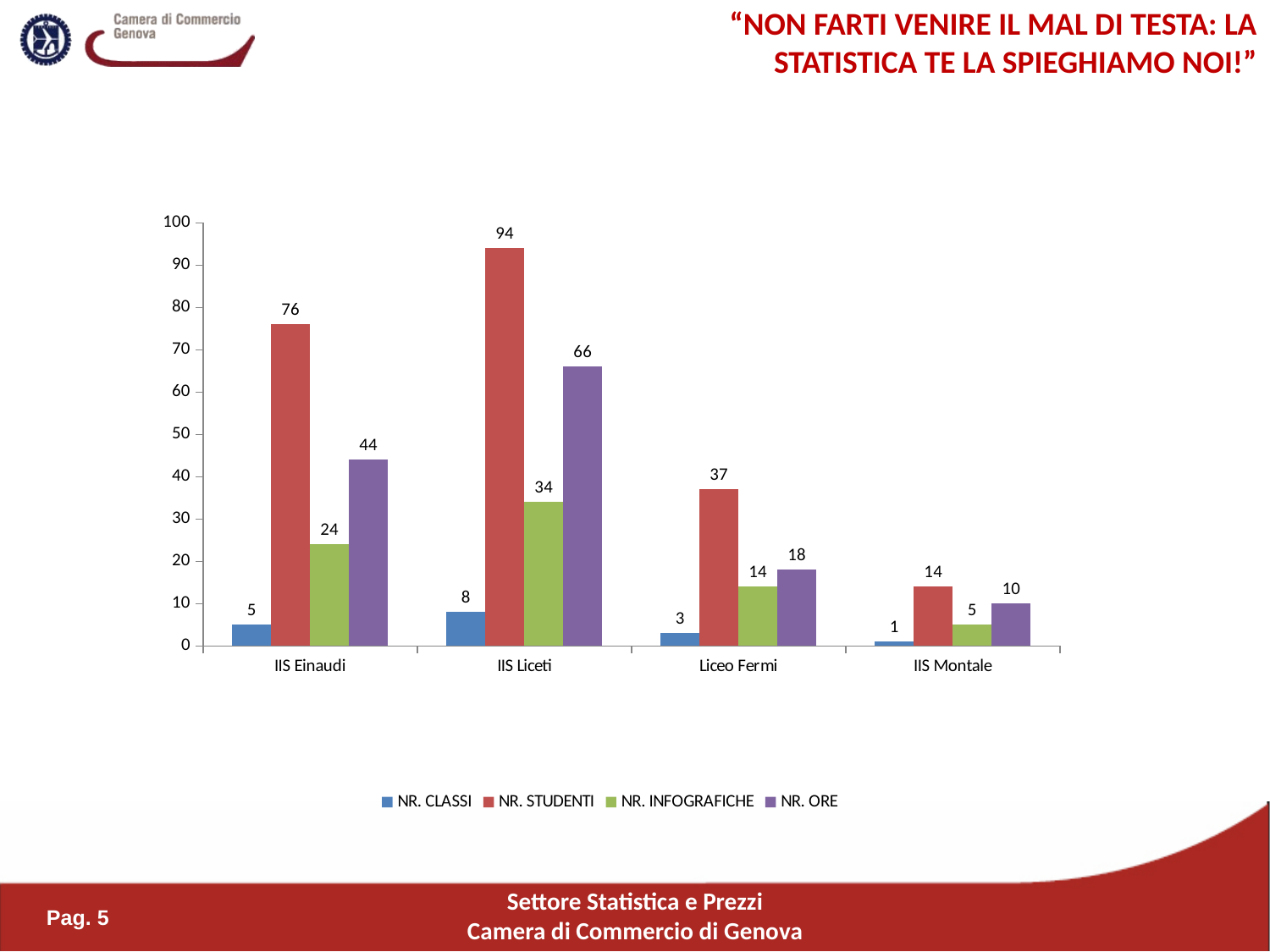
Which is larger: NR. INFOGRAFICHE for IIS Einaudi or NR. ORE for Liceo Fermi? NR. INFOGRAFICHE for IIS Einaudi What is the value of NR. ORE for IIS Einaudi? 44 How many series does the legend list? 4 Which school has the lowest value for NR. ORE? IIS Montale What colour are the NR. ORE bars? Purple How many schools are shown on the x axis? 4 What kind of chart is shown on the slide? Bar chart What is the difference between NR. STUDENTI for IIS Liceti and IIS Einaudi? 18 What is the value of NR. CLASSI for IIS Montale? 1 What is the value of NR. STUDENTI for IIS Liceti? 94 What is the value of NR. INFOGRAFICHE for Liceo Fermi? 14 Which school has the highest value for NR. STUDENTI? IIS Liceti